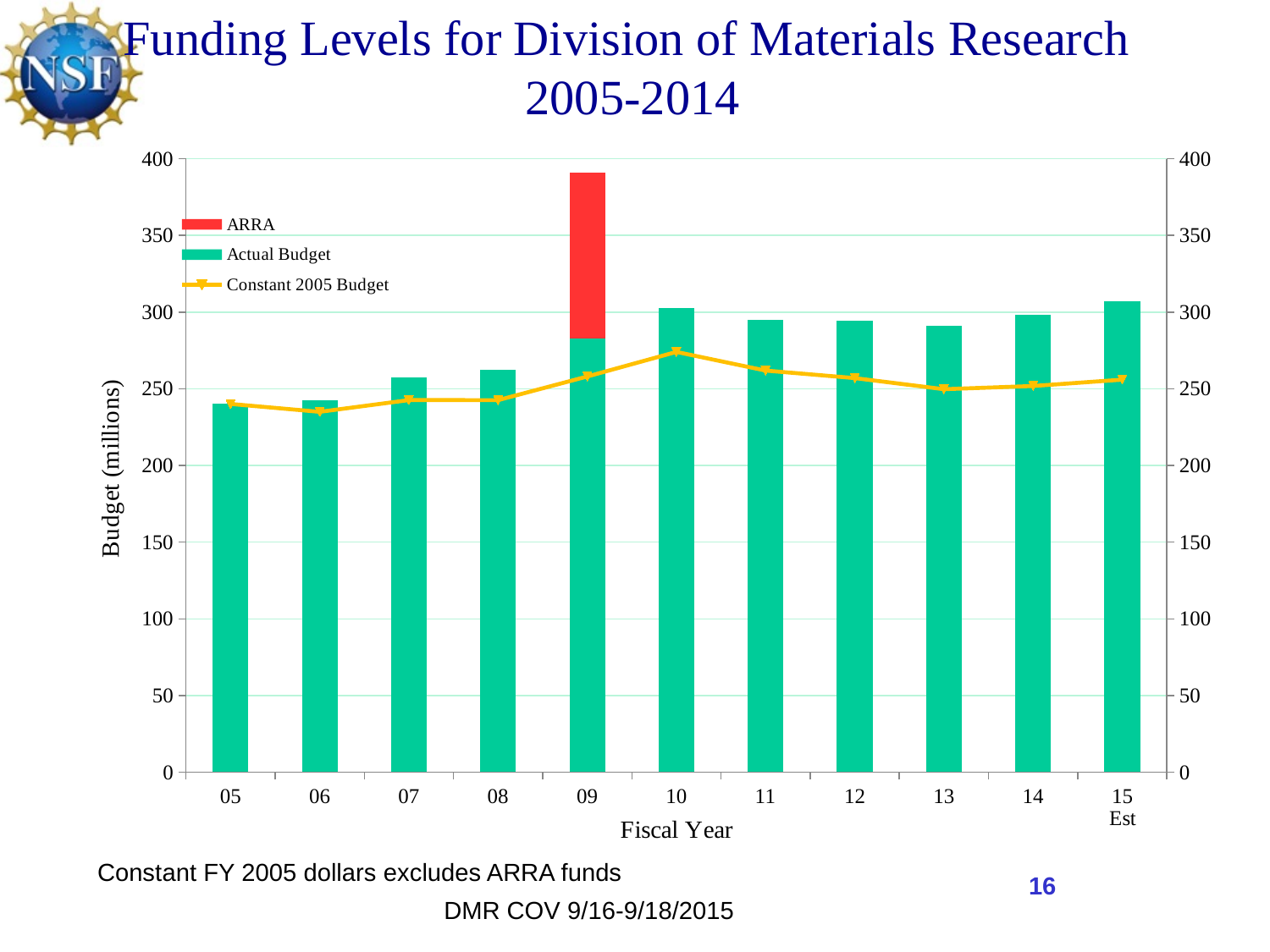
How many fiscal years are shown on the x axis? 11 Do the Actual Budget bars rise or fall from fiscal year 05 to fiscal year 08? rise Which fiscal year has the tallest bar overall? 09 Is the Actual Budget value for fiscal year 13 greater or less than 300? less Is the Constant 2005 Budget value for fiscal year 10 greater or less than 250? greater What kind of chart is shown on the slide? combination bar and line chart Is the Actual Budget value for 15 Est greater or less than 300? greater How many series does the legend list? 3 In which fiscal year does the Constant 2005 Budget line reach its highest point? 10 Which is larger, the Actual Budget bar for fiscal year 09 or for fiscal year 08? 09